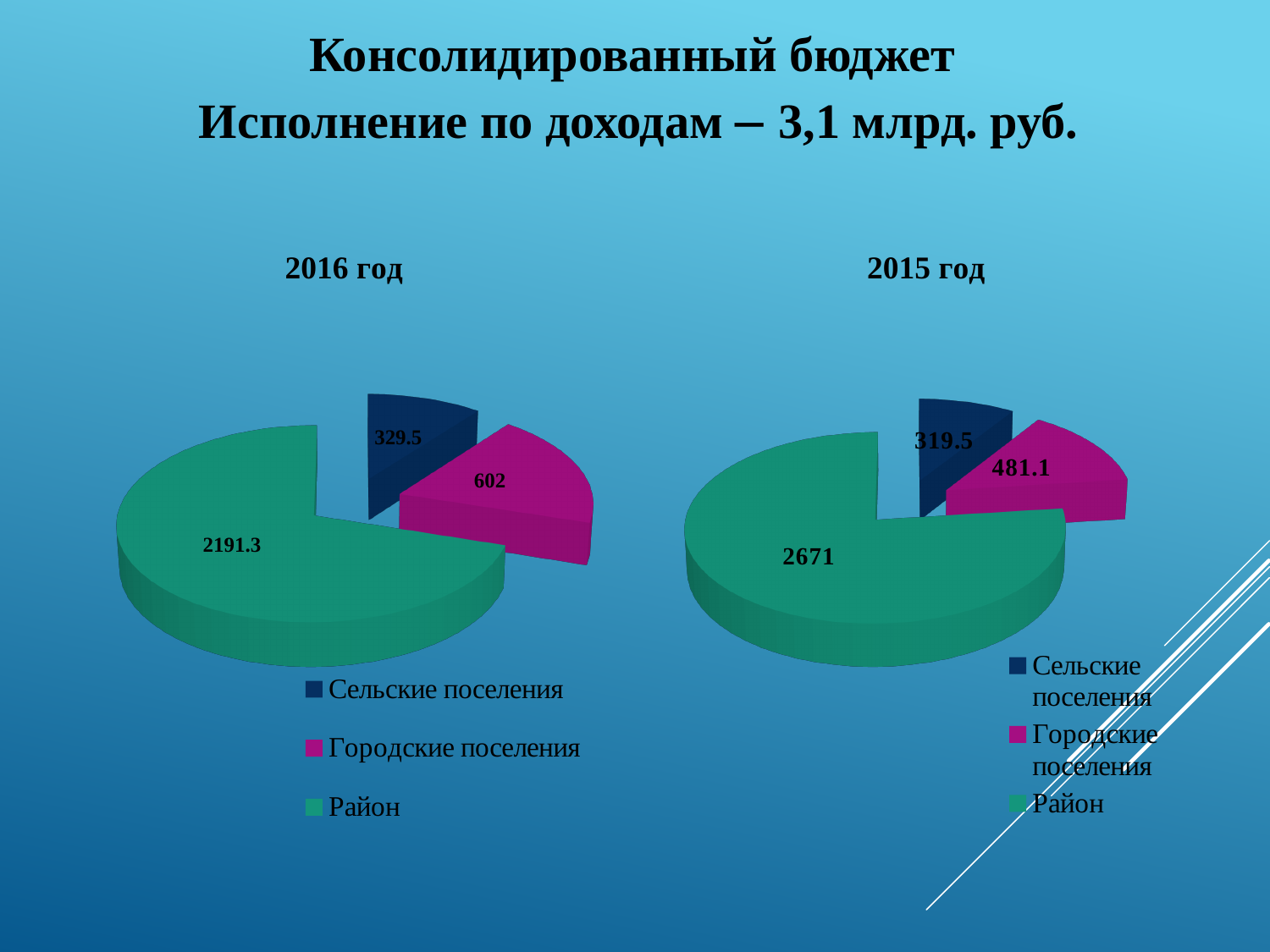
In the 2015 год chart, which category has the largest slice? Район In the 2016 год chart, which colour represents Городские поселения? Magenta In the 2016 год chart, what is the value for Район? 2191.3 How many slices does the 2015 год chart have? 3 What type of chart is the 2016 год chart? Pie chart In the 2015 год chart, what is the value for Сельские поселения? 319.5 In the 2016 год chart, what is the value for Городские поселения? 602 Which is larger: Городские поселения in the 2016 год chart or Городские поселения in the 2015 год chart? 2016 год In the 2016 год chart, which category has the smallest slice? Сельские поселения In the 2016 год chart, what is the difference between Городские поселения and Сельские поселения? 272.5 What is the difference between the Район value in the 2015 год chart and the Район value in the 2016 год chart? 479.7 In the 2015 год chart, what is the value for Городские поселения? 481.1